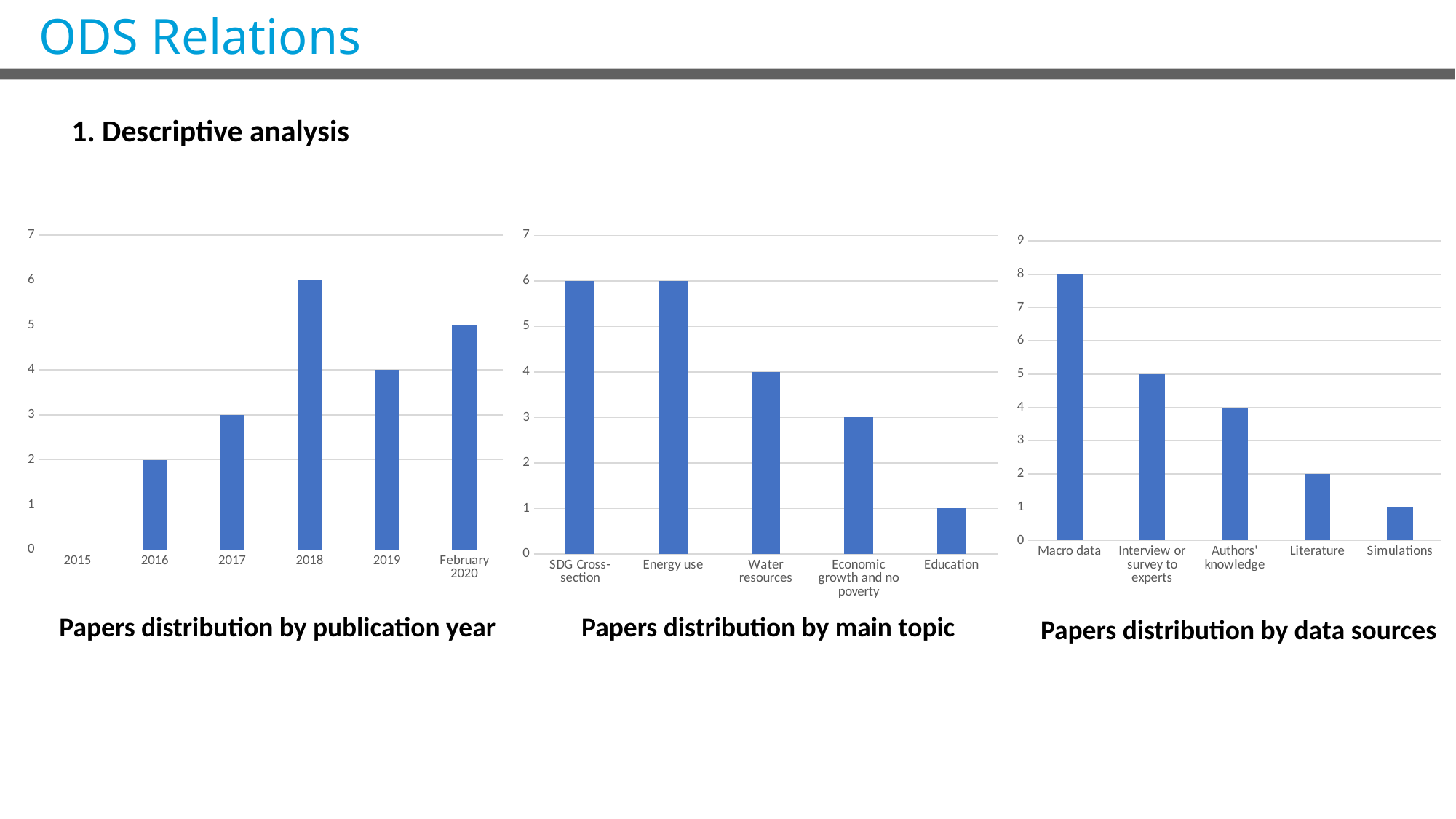
In the 'Papers distribution by publication year' chart, what is the value for 2018? 6 In the 'Papers distribution by data sources' chart, what is the difference between Macro data and Literature? 6 In the 'Papers distribution by main topic' chart, which topic has the lowest value? Education In the 'Papers distribution by publication year' chart, which year has the highest value? 2018 In the 'Papers distribution by publication year' chart, what is the difference between the values for 2018 and 2016? 4 What kind of chart is 'Papers distribution by main topic'? bar chart In the 'Papers distribution by publication year' chart, how many categories are shown on the x axis? 6 In the 'Papers distribution by main topic' chart, what is the value for Water resources? 4 In the 'Papers distribution by data sources' chart, which data source has the lowest value? Simulations In the 'Papers distribution by data sources' chart, what is the value for Macro data? 8 In the 'Papers distribution by main topic' chart, which is larger: Energy use or Economic growth and no poverty? Energy use In the 'Papers distribution by data sources' chart, do the values rise or fall from left to right along the x axis? fall